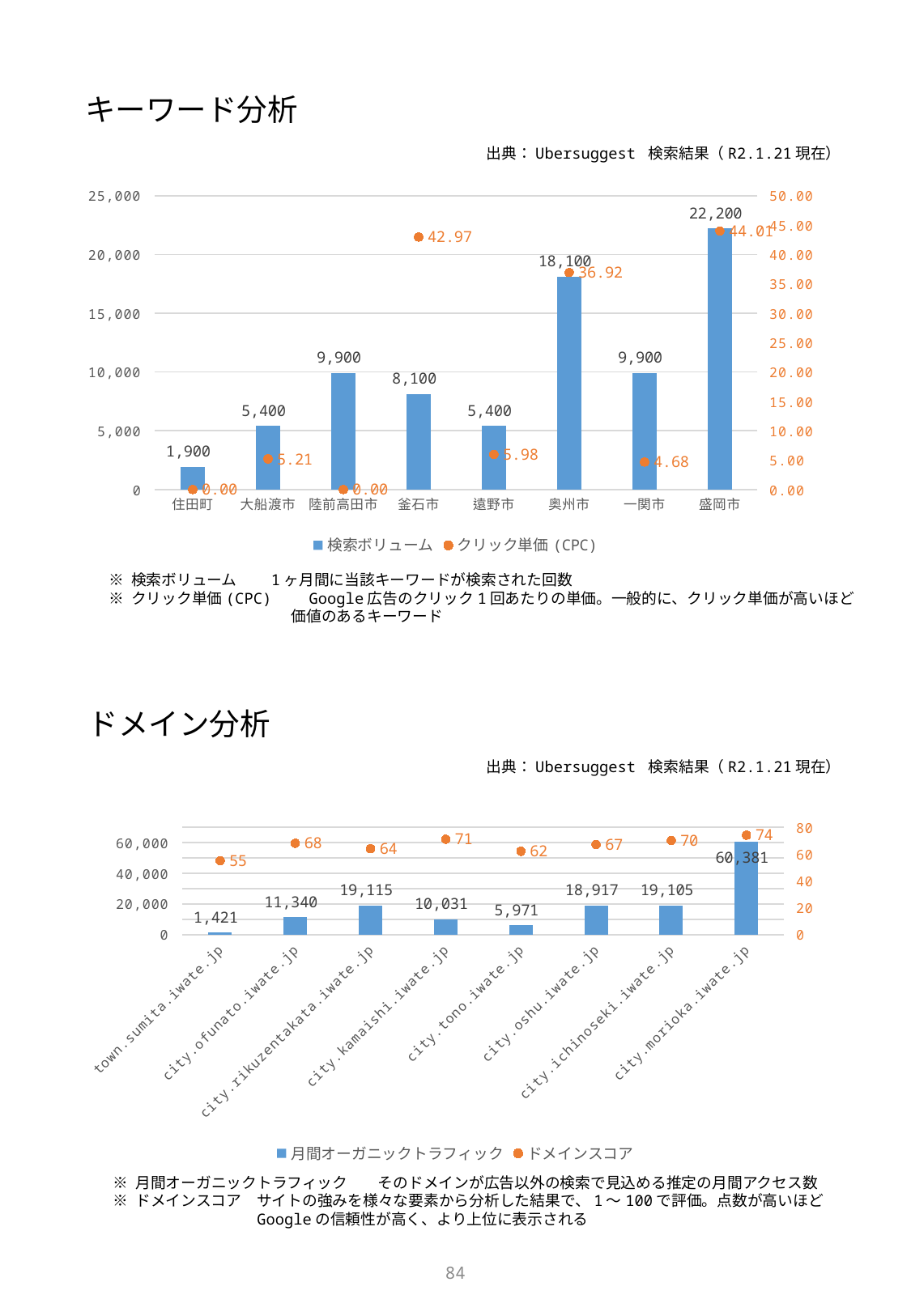
In the キーワード分析 chart, which category has the lowest 検索ボリューム? 住田町 In the キーワード分析 chart, what is the クリック単価 (CPC) for 釜石市? 42.97 In the キーワード分析 chart, how many categories are shown on the x axis? 8 In the キーワード分析 chart, which has the higher クリック単価 (CPC), 奥州市 or 一関市? 奥州市 In the キーワード分析 chart, how many series does the legend list? 2 In the ドメイン分析 chart, what is the 月間オーガニックトラフィック for city.morioka.iwate.jp? 60,381 What kind of chart is the ドメイン分析 chart? Bar chart with a secondary-axis marker series In the ドメイン分析 chart, what is the ドメインスコア for town.sumita.iwate.jp? 55 In the キーワード分析 chart, what is the difference in 検索ボリューム between 盛岡市 and 奥州市? 4,100 In the ドメイン分析 chart, which domain has the highest ドメインスコア? city.morioka.iwate.jp In the ドメイン分析 chart, what is the difference in 月間オーガニックトラフィック between city.rikuzentakata.iwate.jp and city.ichinoseki.iwate.jp? 10 In the キーワード分析 chart, what is the 検索ボリューム for 盛岡市? 22,200